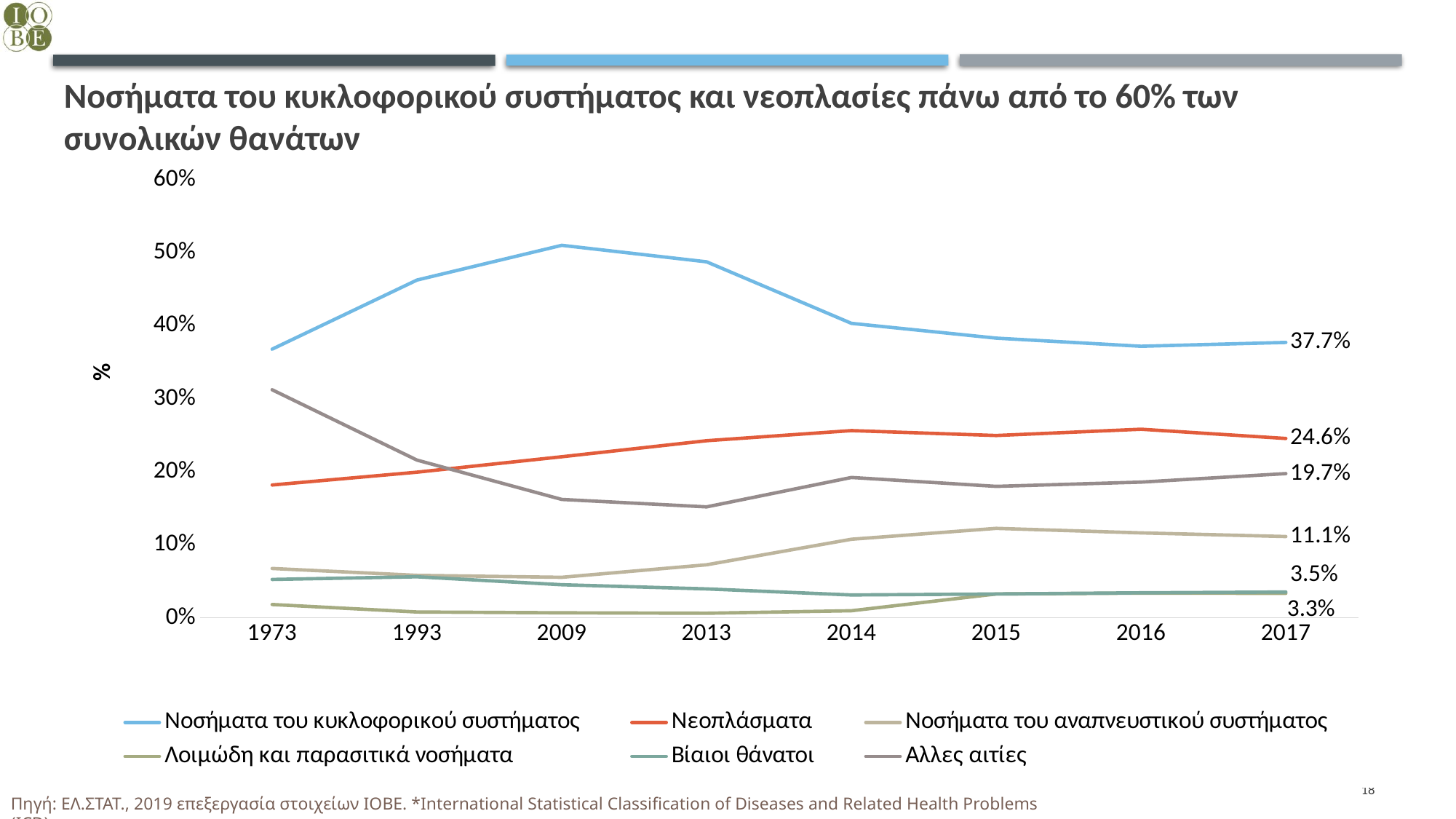
In 1973, which is larger: Άλλες αιτίες or Νεοπλάσματα? Άλλες αιτίες Which series has the highest value in 2017? Νοσήματα του κυκλοφορικού συστήματος Does the Άλλες αιτίες line rise or fall from 1973 to 2013? fall What is the value for Άλλες αιτίες in 2017? 19.7% What type of chart is shown on the slide? line chart How many years are shown on the x axis? 8 What is the value for Νοσήματα του αναπνευστικού συστήματος in 2017? 11.1% What is the value for Νοσήματα του κυκλοφορικού συστήματος in 2017? 37.7% What is the value for Νεοπλάσματα in 2017? 24.6% Is the value for Νοσήματα του κυκλοφορικού συστήματος in 1973 greater or less than 40%? less What is the difference between Νοσήματα του κυκλοφορικού συστήματος and Νεοπλάσματα in 2017? 13.1 percentage points How many series does the legend list? 6